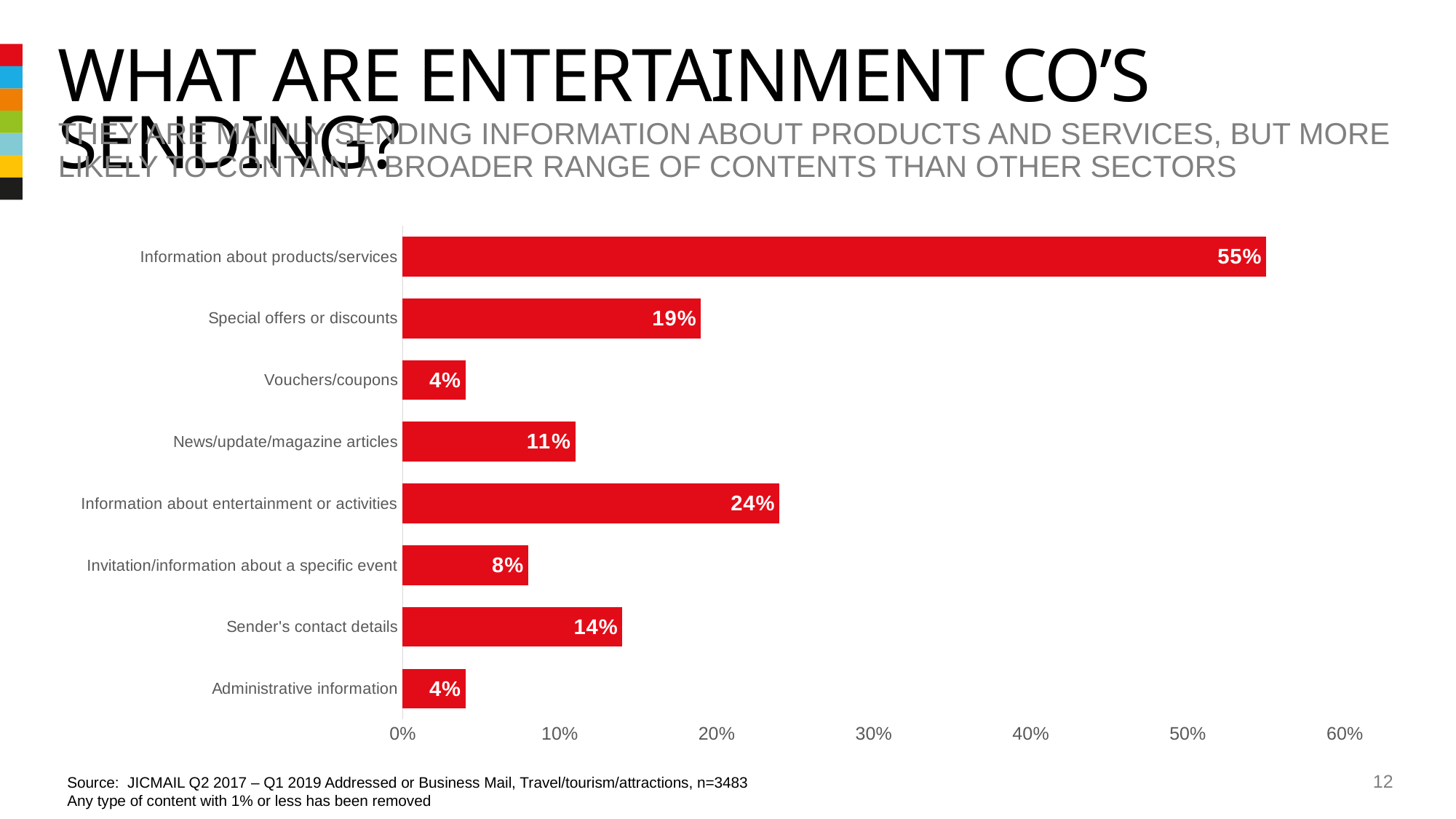
What kind of chart is shown on the slide? bar chart Is the value for Special offers or discounts greater or less than 20%? less Which is larger, Sender's contact details or Invitation/information about a specific event? Sender's contact details What colour are the bars in the chart? red What is the value for Information about entertainment or activities? 24% What is the value for Special offers or discounts? 19% Which category has the highest value? Information about products/services What is the value for Information about products/services? 55% How many categories are shown in the chart? 8 What is the difference between Information about entertainment or activities and News/update/magazine articles? 13% What is the value for Sender's contact details? 14% What is the difference between Information about products/services and Special offers or discounts? 36%